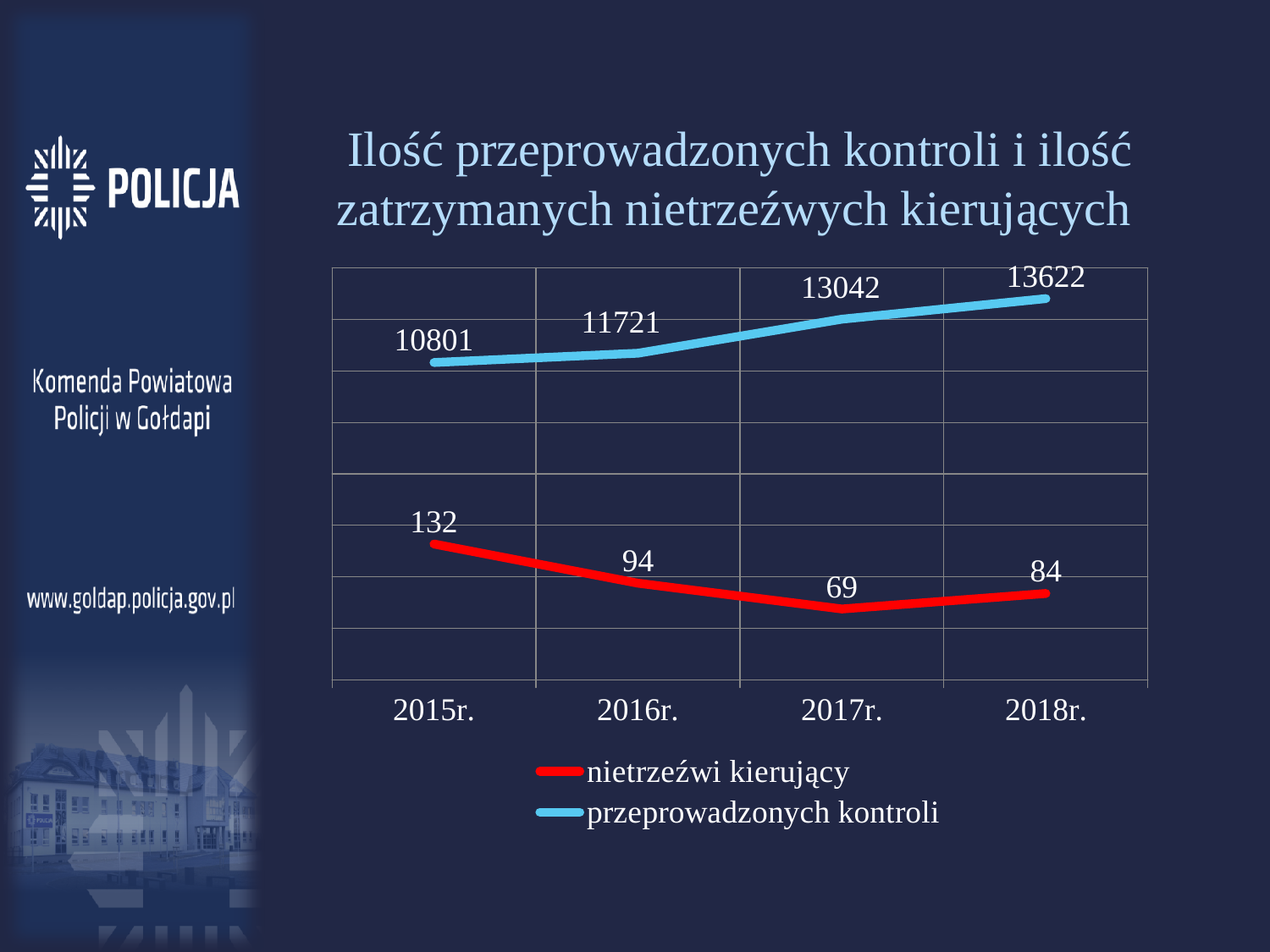
What is the difference between 'przeprowadzonych kontroli' in 2018r. and 2015r.? 2821 What is the value for 'przeprowadzonych kontroli' in 2015r.? 10801 What is the difference between 'nietrzeźwi kierujący' in 2015r. and 2017r.? 63 What is the value for 'nietrzeźwi kierujący' in 2016r.? 94 What is the value for 'nietrzeźwi kierujący' in 2017r.? 69 How many series does the legend list? 2 How many years are shown on the x axis? 4 What is the value for 'przeprowadzonych kontroli' in 2018r.? 13622 In which year is 'przeprowadzonych kontroli' lowest? 2015r. Which is larger: 'nietrzeźwi kierujący' in 2016r. or in 2018r.? 2016r. In which year is 'nietrzeźwi kierujący' highest? 2015r. What kind of chart is shown on the slide? line chart